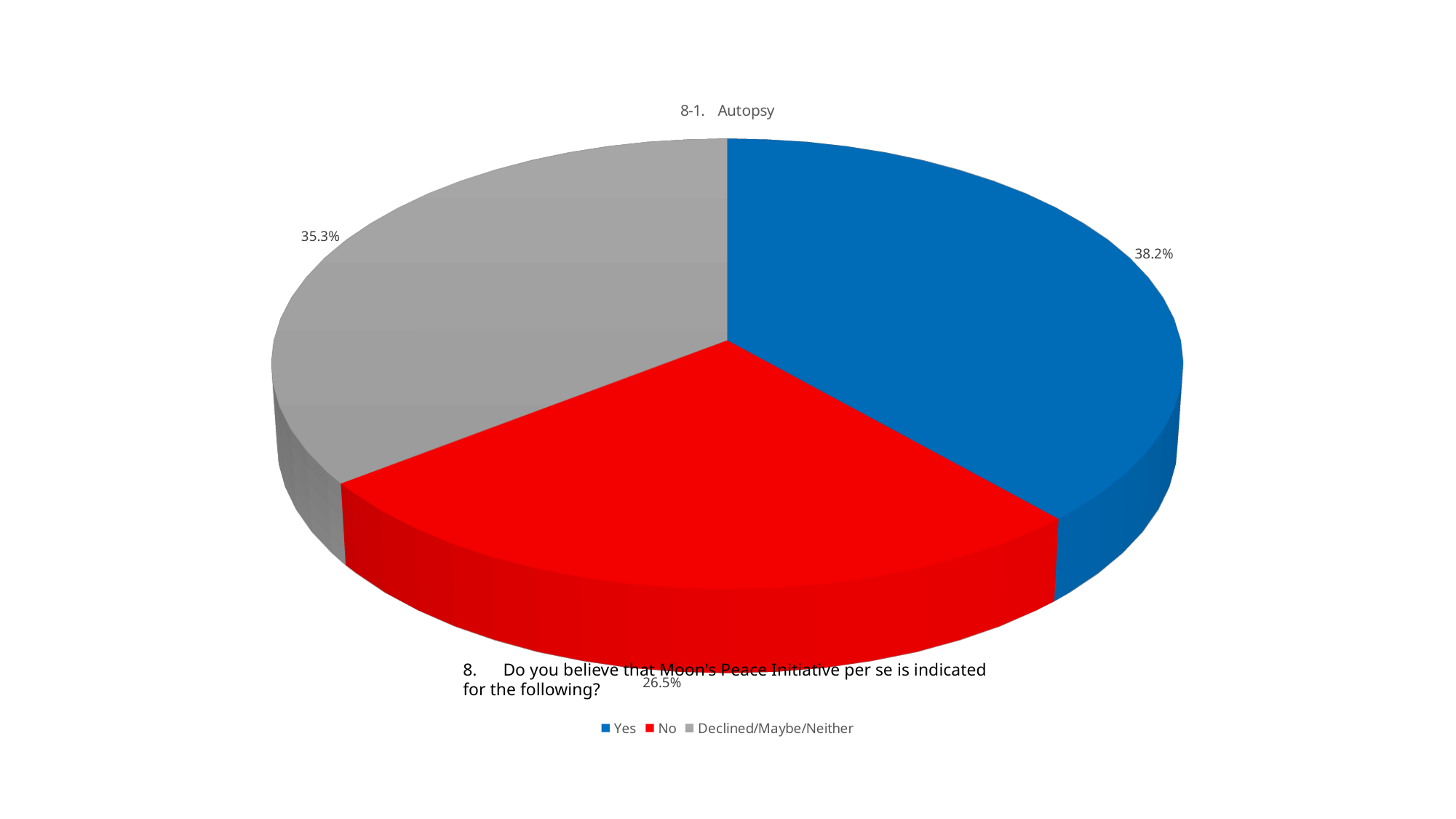
What is the difference in percentage points between the Yes slice and the No slice? 11.7 What is the chart's title? 8-1. Autopsy Which slice is the smallest? No How many slices does the pie chart have? 3 Which slice is the largest? Yes What colour is the No slice? red How many entries does the legend list? 3 What percentage of the pie is the Declined/Maybe/Neither slice? 35.3% What kind of chart is shown on the slide? pie chart What percentage of the pie is the Yes slice? 38.2% What percentage of the pie is the No slice? 26.5% Which is larger, the Declined/Maybe/Neither slice or the No slice? Declined/Maybe/Neither